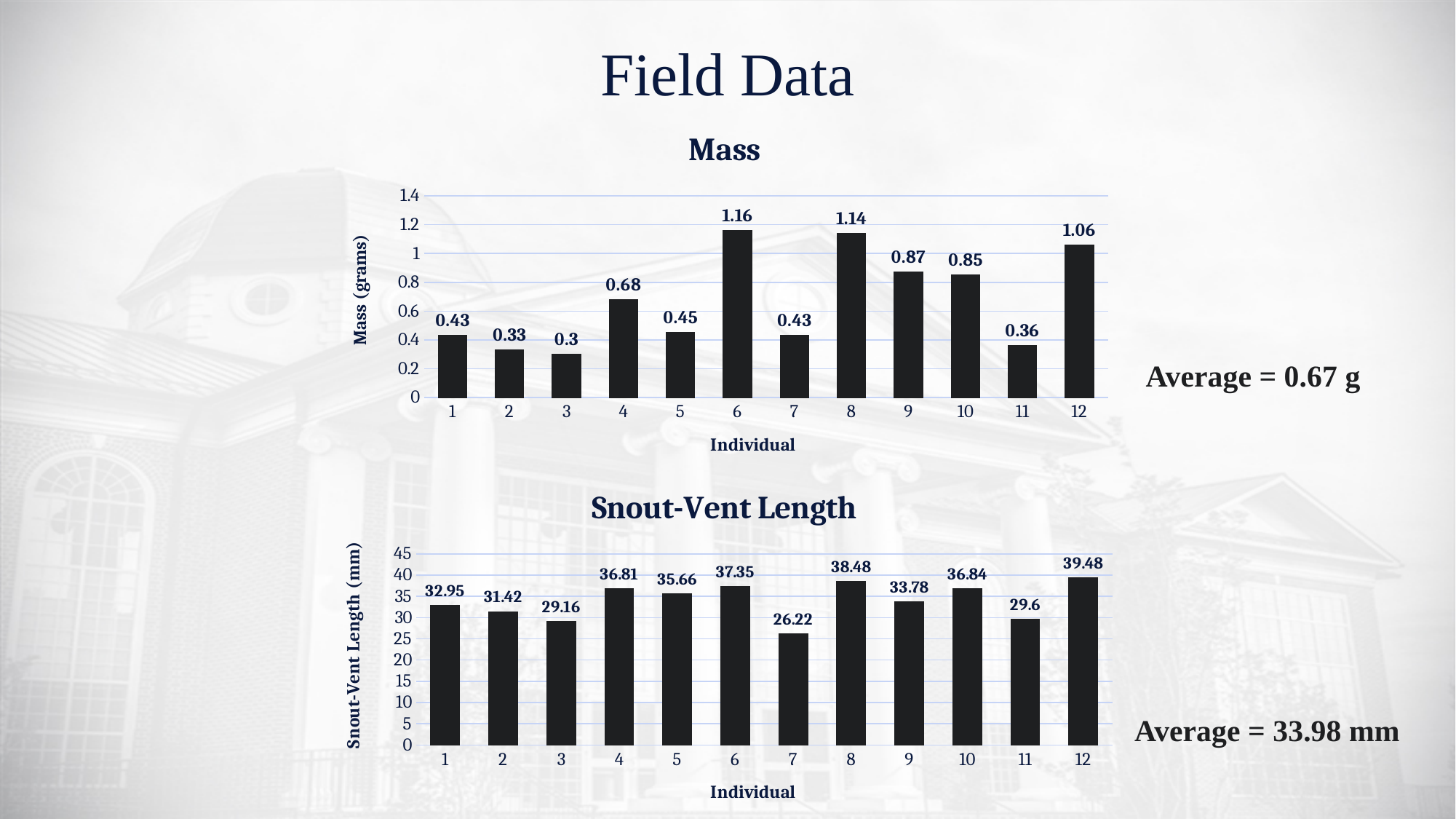
What is the y-axis label of the Mass chart? Mass (grams) In the Mass chart, which individual has the lowest mass? 3 In the Snout-Vent Length chart, which individual has the lowest snout-vent length? 7 In the Mass chart, which individual has the highest mass? 6 In the Snout-Vent Length chart, what is the value for individual 7? 26.22 In the Mass chart, what is the mass of individual 6? 1.16 In the Mass chart, what is the difference in mass between individual 8 and individual 11? 0.78 In the Snout-Vent Length chart, what is the difference between the values for individual 12 and individual 1? 6.53 What kind of chart is the Mass chart? bar chart In the Snout-Vent Length chart, which individual has the highest snout-vent length? 12 In the Mass chart, how many individuals are plotted? 12 In the Snout-Vent Length chart, which is larger, the value for individual 4 or individual 10? individual 10